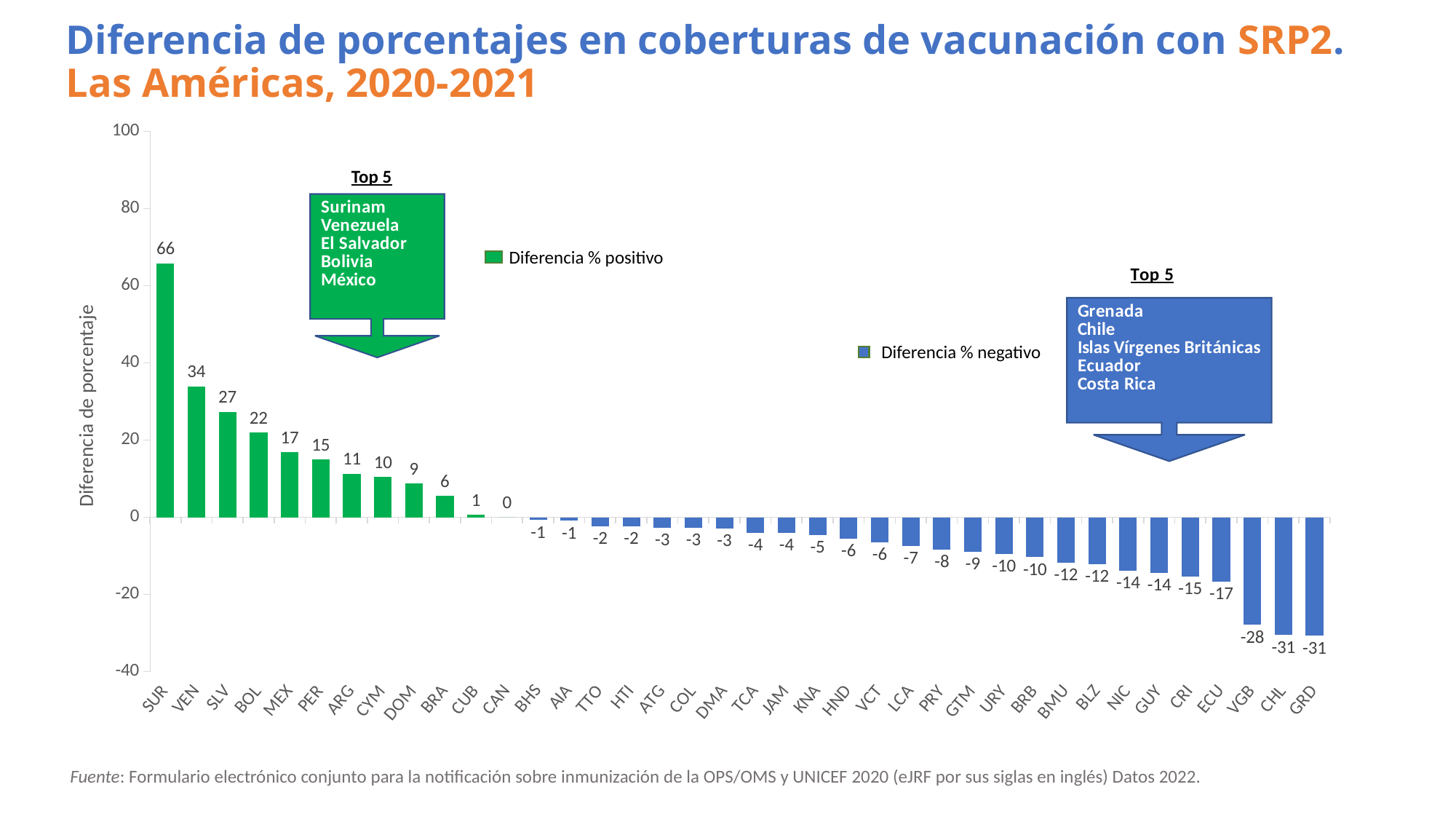
What is the difference between the values for SUR and VEN? 32 What is the value for MEX? 17 How many series does the legend list? 2 What is the difference between the values for ECU and VGB? 11 What is the value for SUR? 66 Do the values rise or fall from left to right along the x axis? Fall Which has the larger value, VEN or SLV? VEN What kind of chart is this? Bar chart How many countries are shown on the x axis? 38 Which country has the highest value? SUR What is the value for ECU? -17 What is the value for VGB? -28